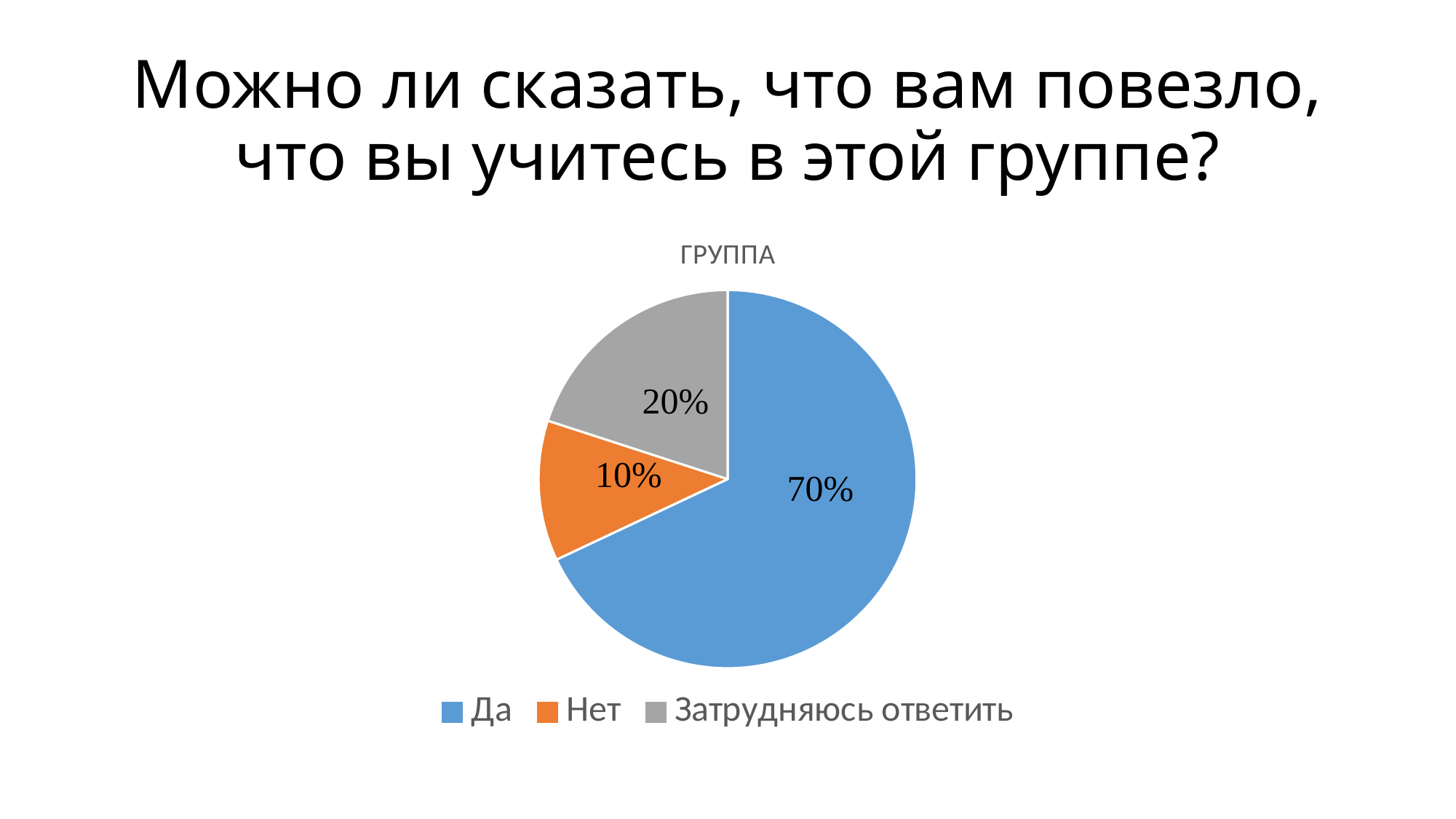
What is the difference in percentage points between "Затрудняюсь ответить" and "Нет"? 10 Which category has the largest slice of the pie? Да What share of the pie does "Затрудняюсь ответить" take? 20% Which category has the smallest slice of the pie? Нет How many categories does the pie chart show? 3 What colour is the slice for "Нет"? Orange What share of the pie does "Да" take? 70% What is the difference in percentage points between "Да" and "Затрудняюсь ответить"? 50 What kind of chart is shown on the slide? Pie chart What is the title of the chart? ГРУППА Which is larger, the slice for "Нет" or the slice for "Затрудняюсь ответить"? Затрудняюсь ответить What share of the pie does "Нет" take? 10%